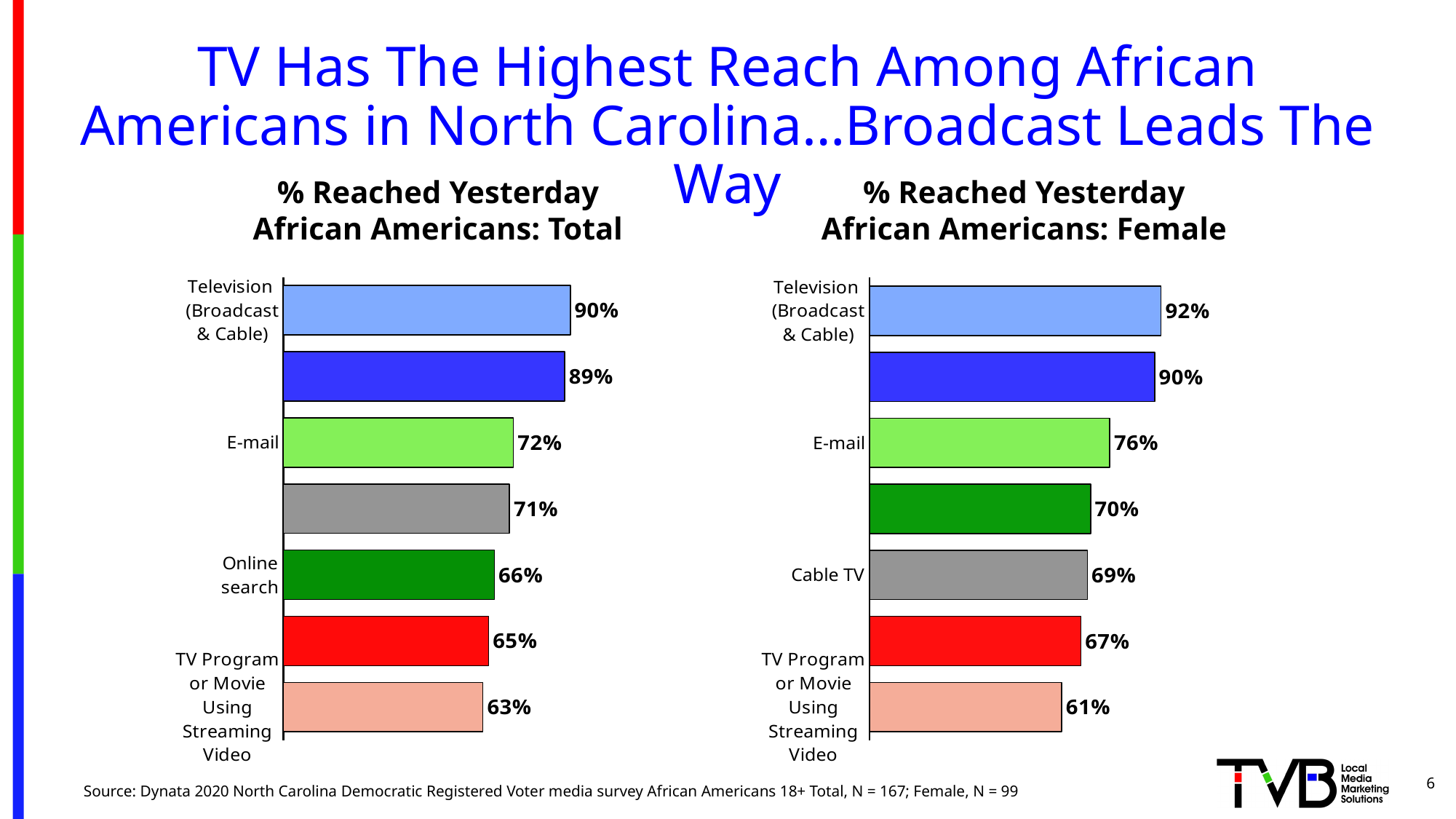
What type of chart is the '% Reached Yesterday African Americans: Female' chart? Bar chart In the '% Reached Yesterday African Americans: Female' chart, what is the value for Cable TV? 69% In the '% Reached Yesterday African Americans: Female' chart, which is larger, E-mail or Cable TV? E-mail In the '% Reached Yesterday African Americans: Total' chart, what is the difference between Television (Broadcast & Cable) and E-mail? 18% In the '% Reached Yesterday African Americans: Total' chart, what is the value for E-mail? 72% In the '% Reached Yesterday African Americans: Female' chart, which category has the lowest value? TV Program or Movie Using Streaming Video In the '% Reached Yesterday African Americans: Total' chart, what is the value for Television (Broadcast & Cable)? 90% In the '% Reached Yesterday African Americans: Total' chart, which category has the highest value? Television (Broadcast & Cable) How many bars are plotted in the '% Reached Yesterday African Americans: Total' chart? 7 In the '% Reached Yesterday African Americans: Female' chart, what is the value for Television (Broadcast & Cable)? 92% In the '% Reached Yesterday African Americans: Total' chart, what is the value for Online search? 66% In the '% Reached Yesterday African Americans: Female' chart, what is the value for TV Program or Movie Using Streaming Video? 61%